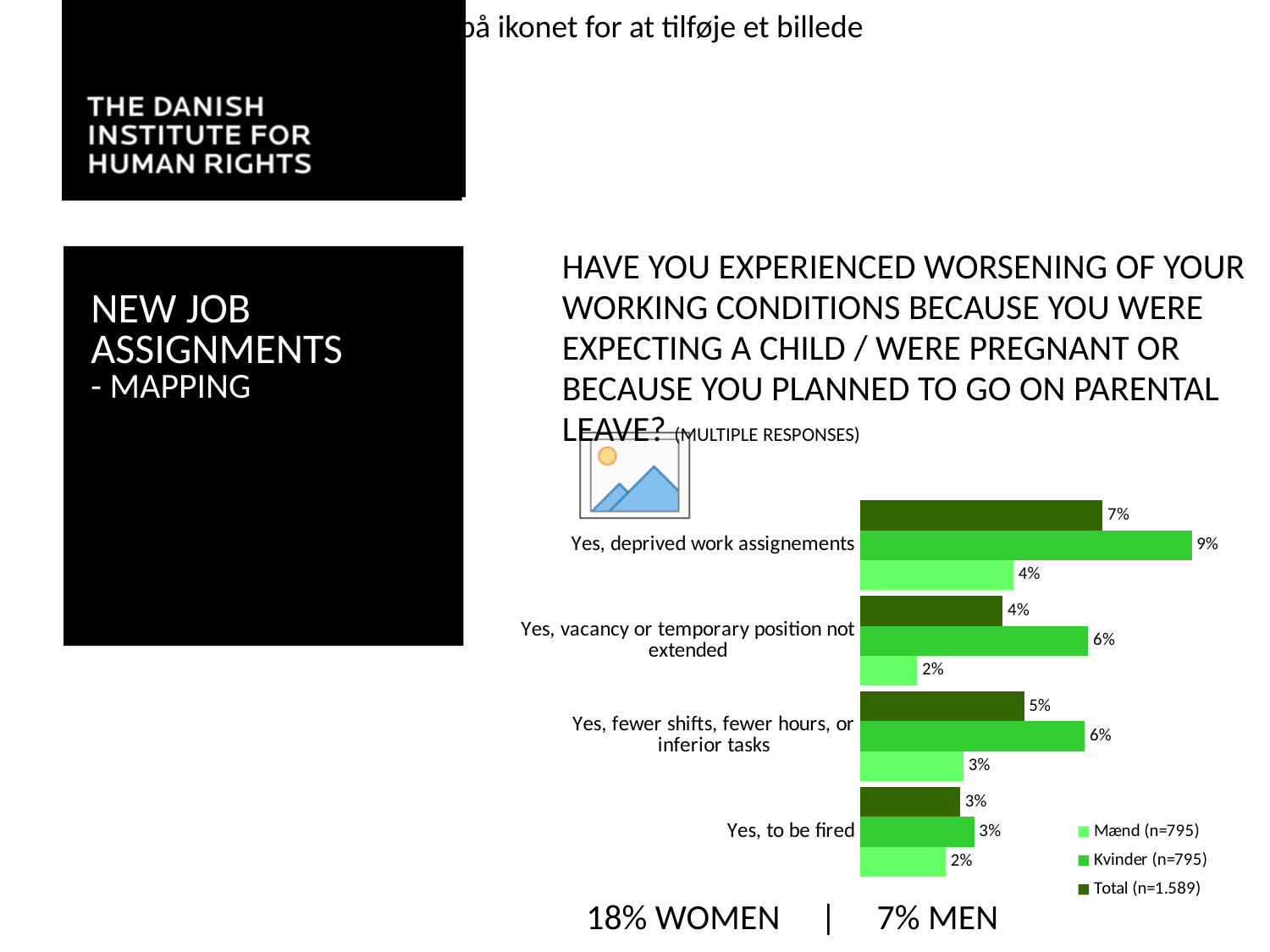
What is the Total (n=1.589) value for 'Yes, fewer shifts, fewer hours, or inferior tasks'? 5% How many series does the chart legend list? 3 Which category has the highest Kvinder (n=795) value? Yes, deprived work assignements Which series is shown in the darkest green in the chart? Total (n=1.589) How many response categories are shown in the chart? 4 Which category has the lowest Total (n=1.589) value? Yes, to be fired What is the Mænd (n=795) value for 'Yes, to be fired'? 2% For 'Yes, vacancy or temporary position not extended', which is larger: the Kvinder (n=795) value or the Total (n=1.589) value? Kvinder (n=795) What is the difference between the Kvinder (n=795) and Mænd (n=795) values for 'Yes, deprived work assignements'? 5% What kind of chart is shown on the slide? bar chart What is the Kvinder (n=795) value for 'Yes, deprived work assignements'? 9% What is the Mænd (n=795) value for 'Yes, vacancy or temporary position not extended'? 2%